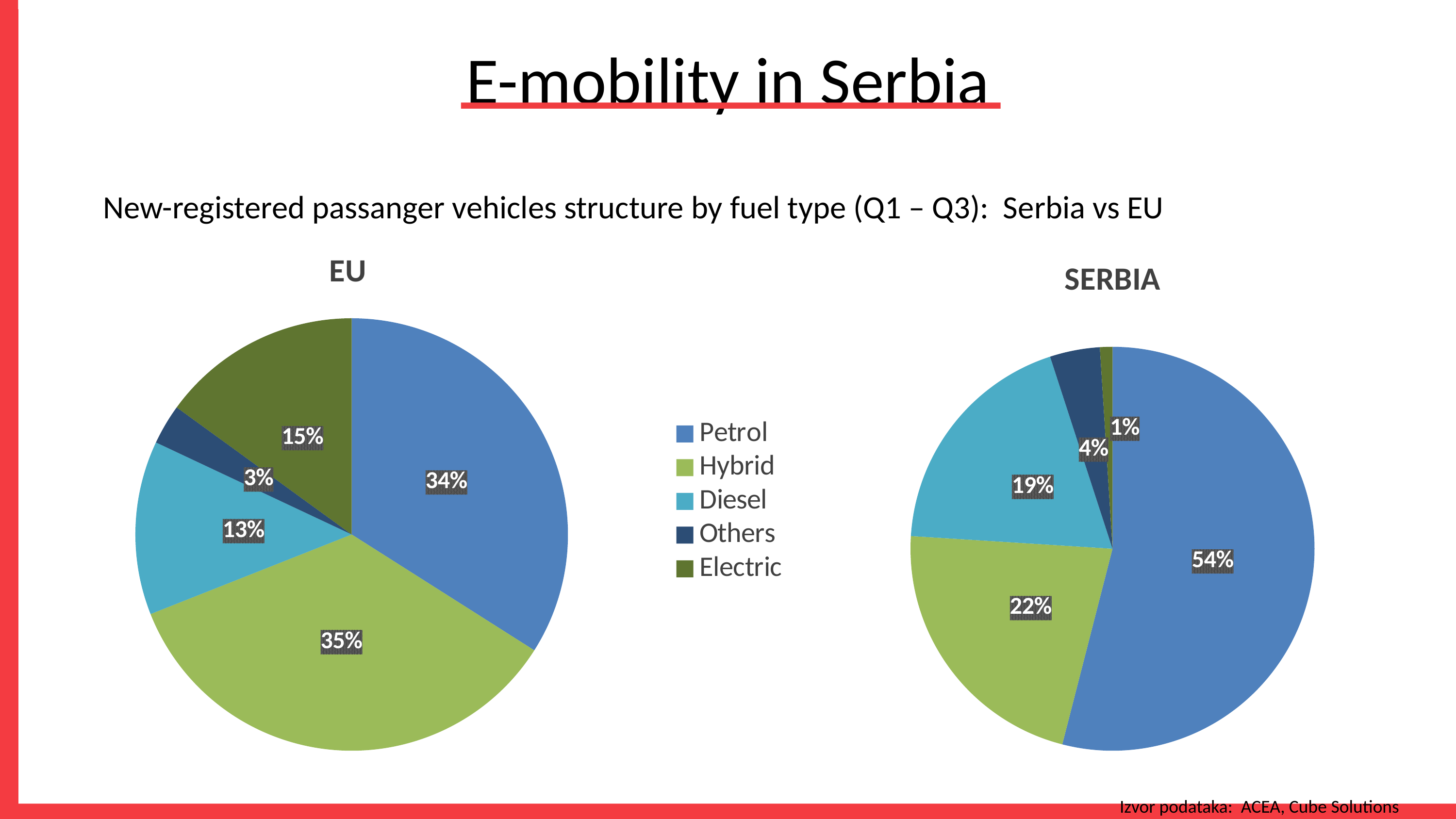
How many fuel types does the legend list? 5 In the SERBIA chart, what is the share for Diesel? 19% In the SERBIA chart, what share of new-registered passenger vehicles is Petrol? 54% Is the Petrol share larger in the EU chart or in the SERBIA chart? SERBIA In the EU chart, what is the share for Diesel? 13% In the SERBIA chart, what is the difference between the Hybrid share and the Diesel share? 3% What is the difference between the Electric share in the EU chart and the Electric share in the SERBIA chart? 14% In the SERBIA chart, which fuel type has the smallest share? Electric In the SERBIA chart, which fuel type has the largest share? Petrol What kind of chart is used for the EU and SERBIA data? Pie chart In the EU chart, which fuel type has the smallest share? Others In the EU chart, what share of new-registered passenger vehicles is Electric? 15%